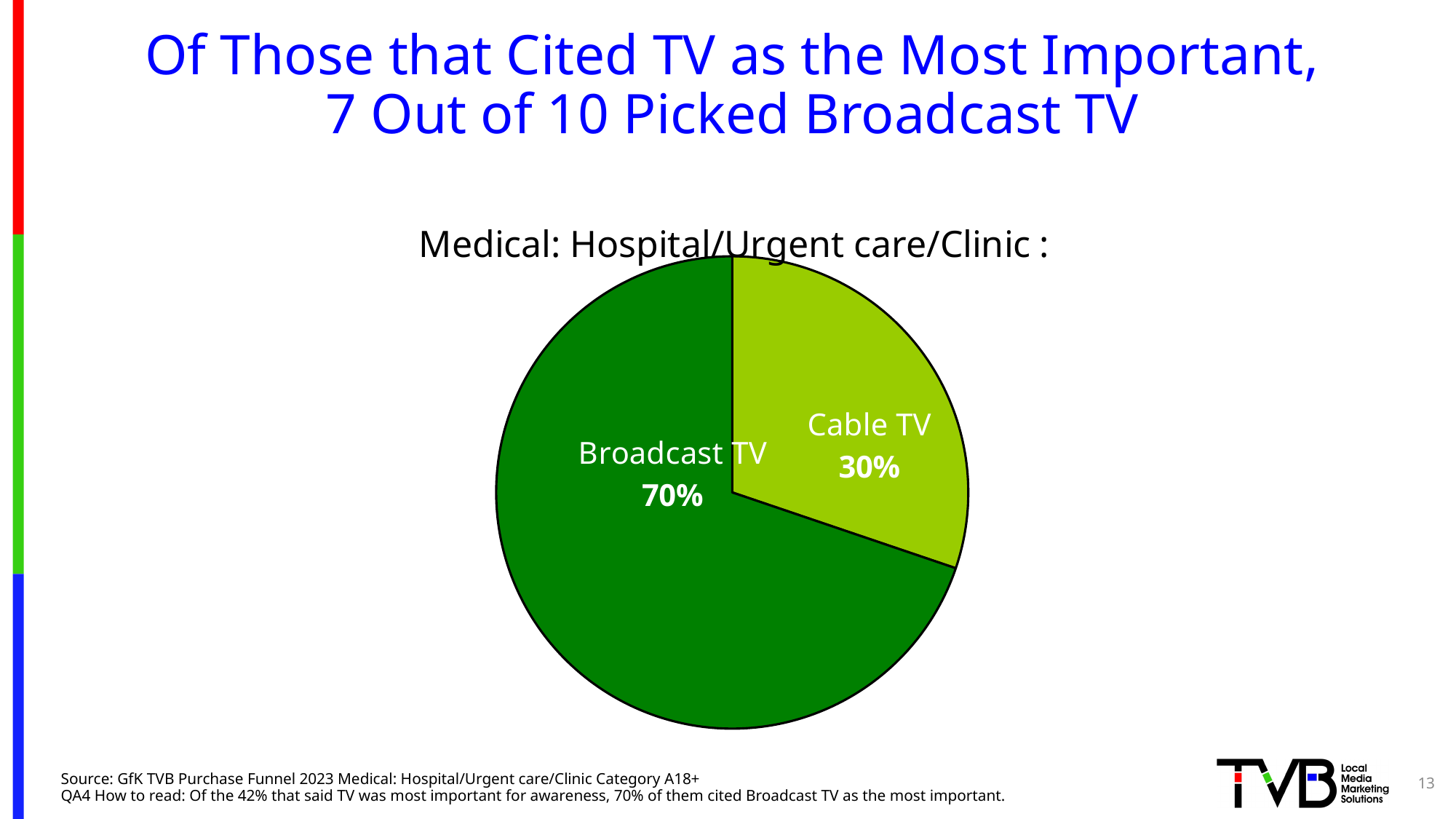
Which is larger, the Broadcast TV slice or the Cable TV slice? Broadcast TV Which slice of the pie is the smallest? Cable TV What share of the pie does Broadcast TV represent? 70% What share of the pie does Cable TV represent? 30% What type of chart is shown on the slide? pie chart What is the total of the two slices shown in the pie chart? 100% Which slice of the pie is the largest? Broadcast TV What is the title of the pie chart? Medical: Hospital/Urgent care/Clinic : How many slices does the pie chart have? 2 What colour is the Cable TV slice? light green What is the difference in percentage points between Broadcast TV and Cable TV? 40